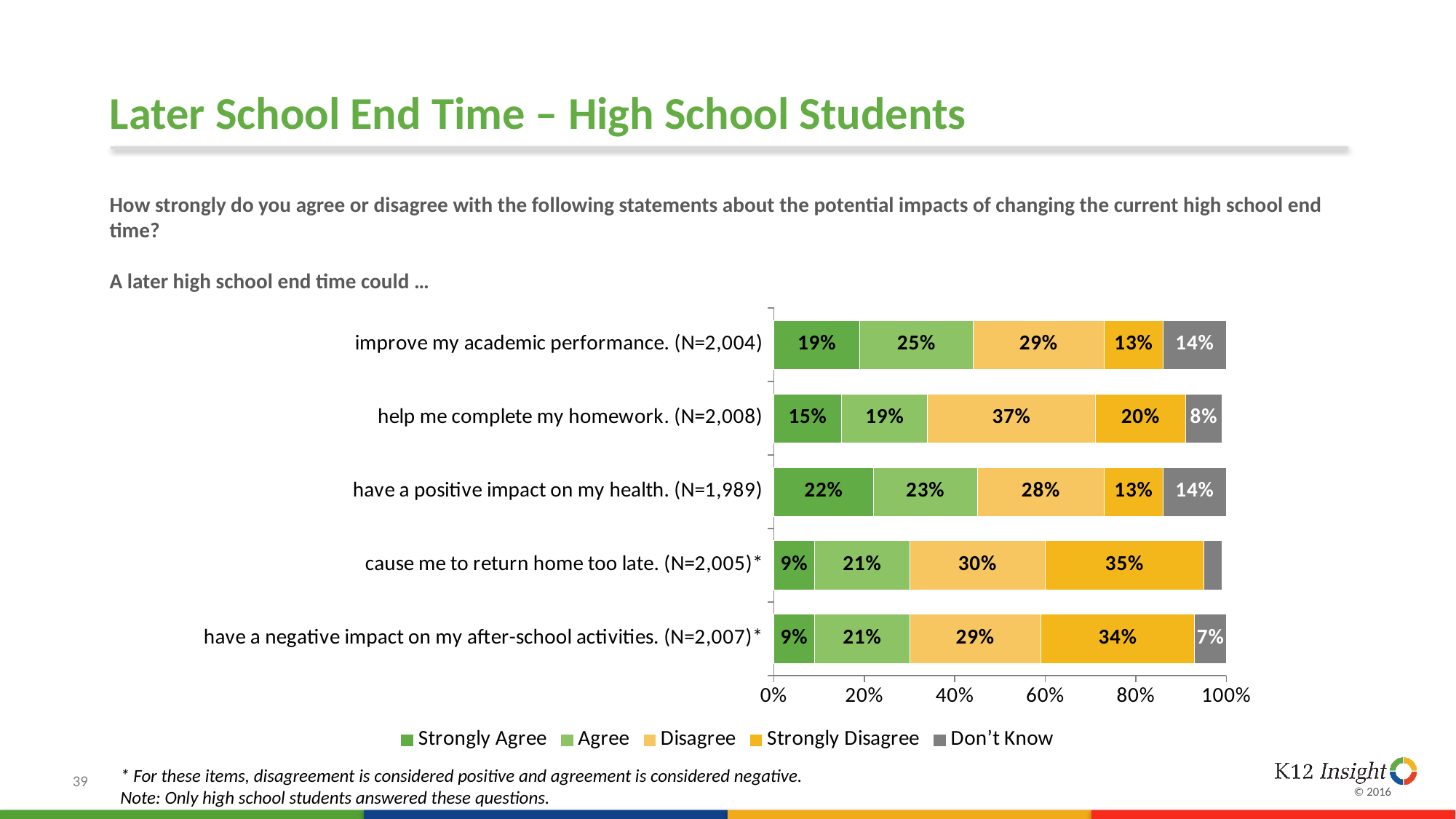
What kind of chart is shown on the slide? Stacked bar chart Which statement has the lowest Disagree percentage? have a positive impact on my health. (N=1,989) Which statement has the highest Strongly Agree percentage? have a positive impact on my health. (N=1,989) How many statements are shown in the chart? 5 How many response categories does the legend list? 5 What percentage of students strongly disagree that a later high school end time could cause them to return home too late? 35% What is the sample size (N) for the statement 'improve my academic performance'? 2,004 What is the Don't Know percentage for the statement 'have a negative impact on my after-school activities'? 7% Which is larger: the Agree percentage for 'improve my academic performance' or the Agree percentage for 'help me complete my homework'? improve my academic performance What percentage of students strongly agree that a later high school end time could have a positive impact on their health? 22% What percentage of students disagree that a later high school end time could help them complete their homework? 37% What is the difference between the Strongly Disagree percentages for 'cause me to return home too late' and 'have a negative impact on my after-school activities'? 1%